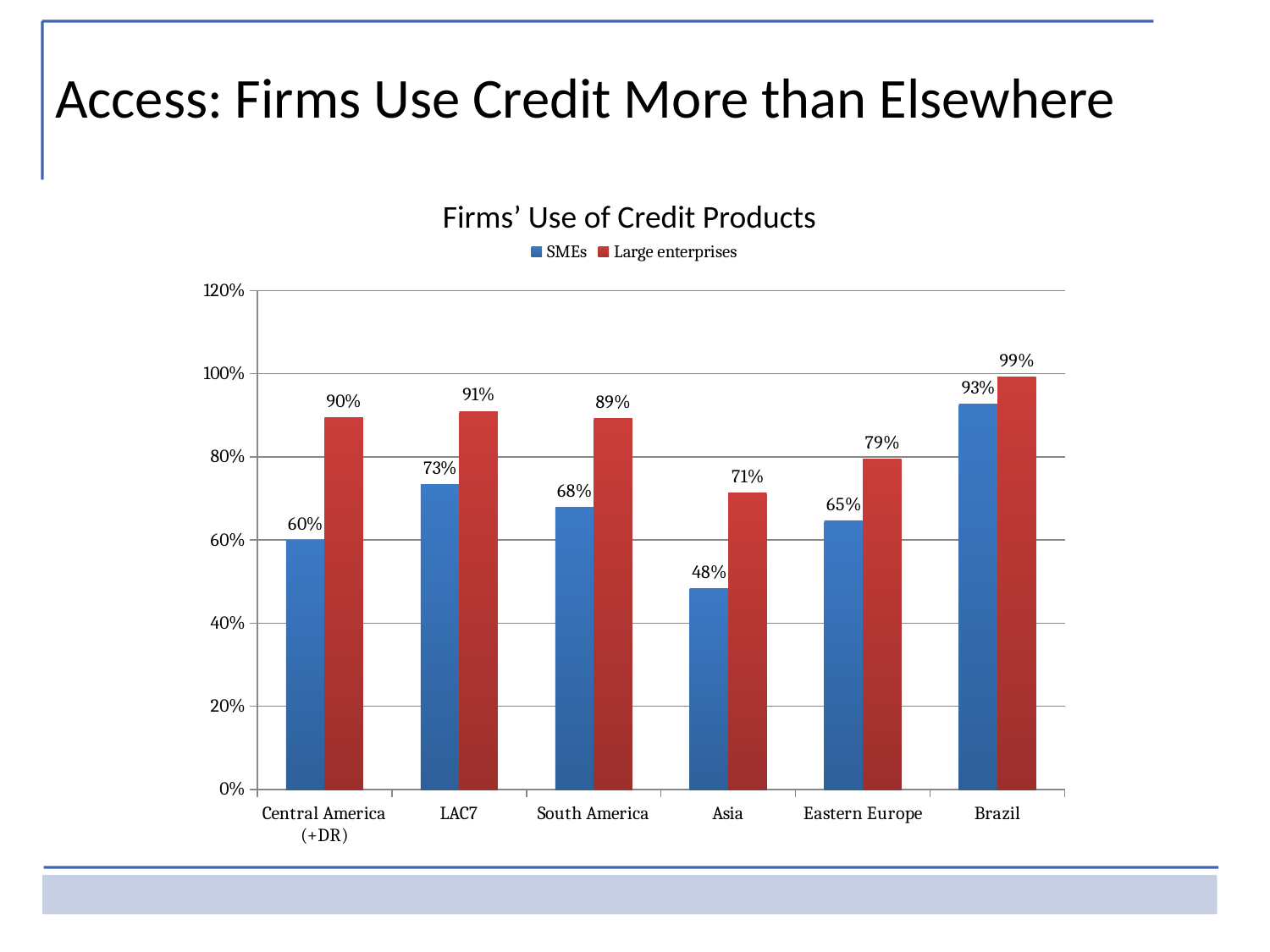
How many categories are shown on the x axis? 6 What is the SMEs value for Asia? 48% Which category has the highest Large enterprises value? Brazil How many series does the legend list? 2 What kind of chart is shown on the slide? bar chart What is the title of the chart? Firms' Use of Credit Products Is the Large enterprises value for Asia greater or less than 80%? less Which category has the lowest SMEs value? Asia What is the SMEs value for Central America (+DR)? 60% What is the Large enterprises value for Brazil? 99% Which is larger, the SMEs value for LAC7 or the SMEs value for South America? LAC7 What is the difference between the Large enterprises and SMEs values for Eastern Europe? 14%